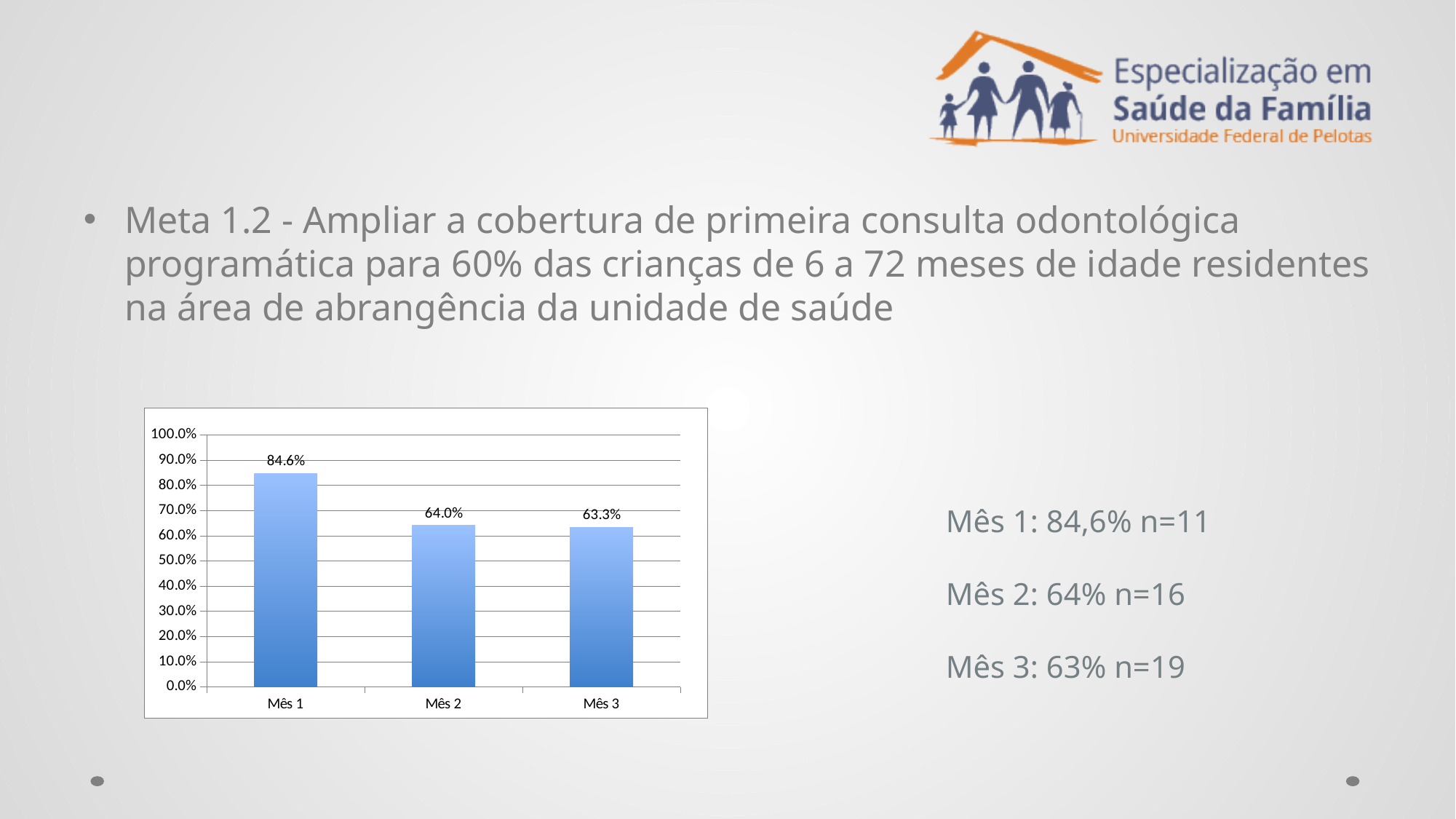
What kind of chart is shown on the slide? bar chart What is the difference between the values for Mês 1 and Mês 3? 21.3% What is the value for Mês 3? 63.3% What is the value for Mês 1? 84.6% Which is larger, the value for Mês 1 or the value for Mês 3? Mês 1 How many categories are shown on the x axis? 3 What is the value for Mês 2? 64.0% Is the value for Mês 1 greater or less than 80.0%? greater What is the difference between the values for Mês 1 and Mês 2? 20.6% Which month has the lowest value? Mês 3 Which month has the highest value? Mês 1 Do the values rise or fall from Mês 1 to Mês 3? fall